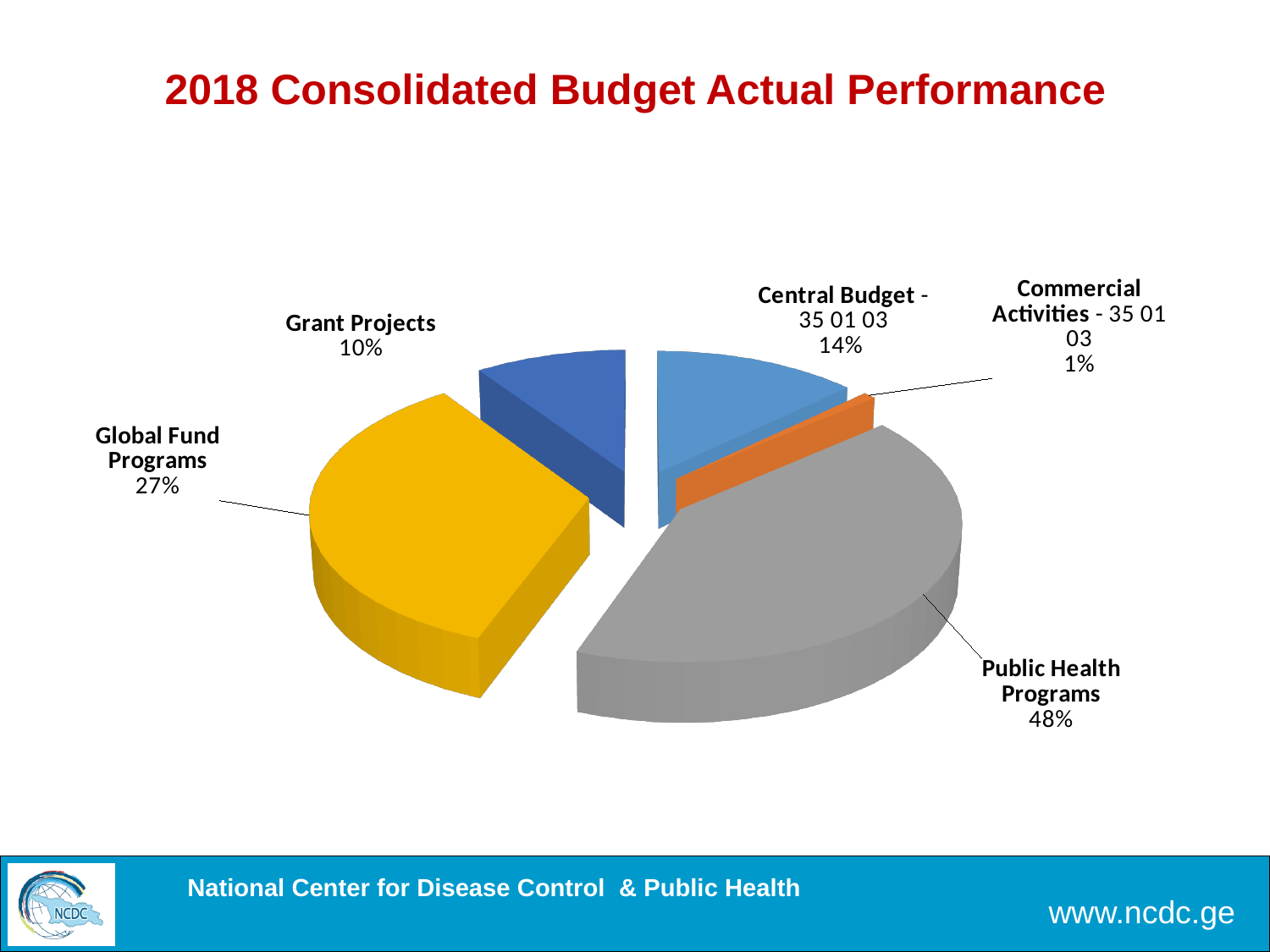
What is the title of the slide containing the pie chart? 2018 Consolidated Budget Actual Performance Which is larger, the share for Central Budget - 35 01 03 or the share for Grant Projects? Central Budget - 35 01 03 What is the value shown for Central Budget - 35 01 03? 14% What share of the pie does Public Health Programs represent? 48% What is the value shown for Grant Projects? 10% Which category has the largest share of the pie? Public Health Programs Which category has the smallest share of the pie? Commercial Activities - 35 01 03 What is the value shown for Commercial Activities - 35 01 03? 1% What is the value shown for Global Fund Programs? 27% How many slices does the pie chart have? 5 What kind of chart is shown on the slide? Pie chart What is the difference in percentage points between Public Health Programs and Global Fund Programs? 21 percentage points